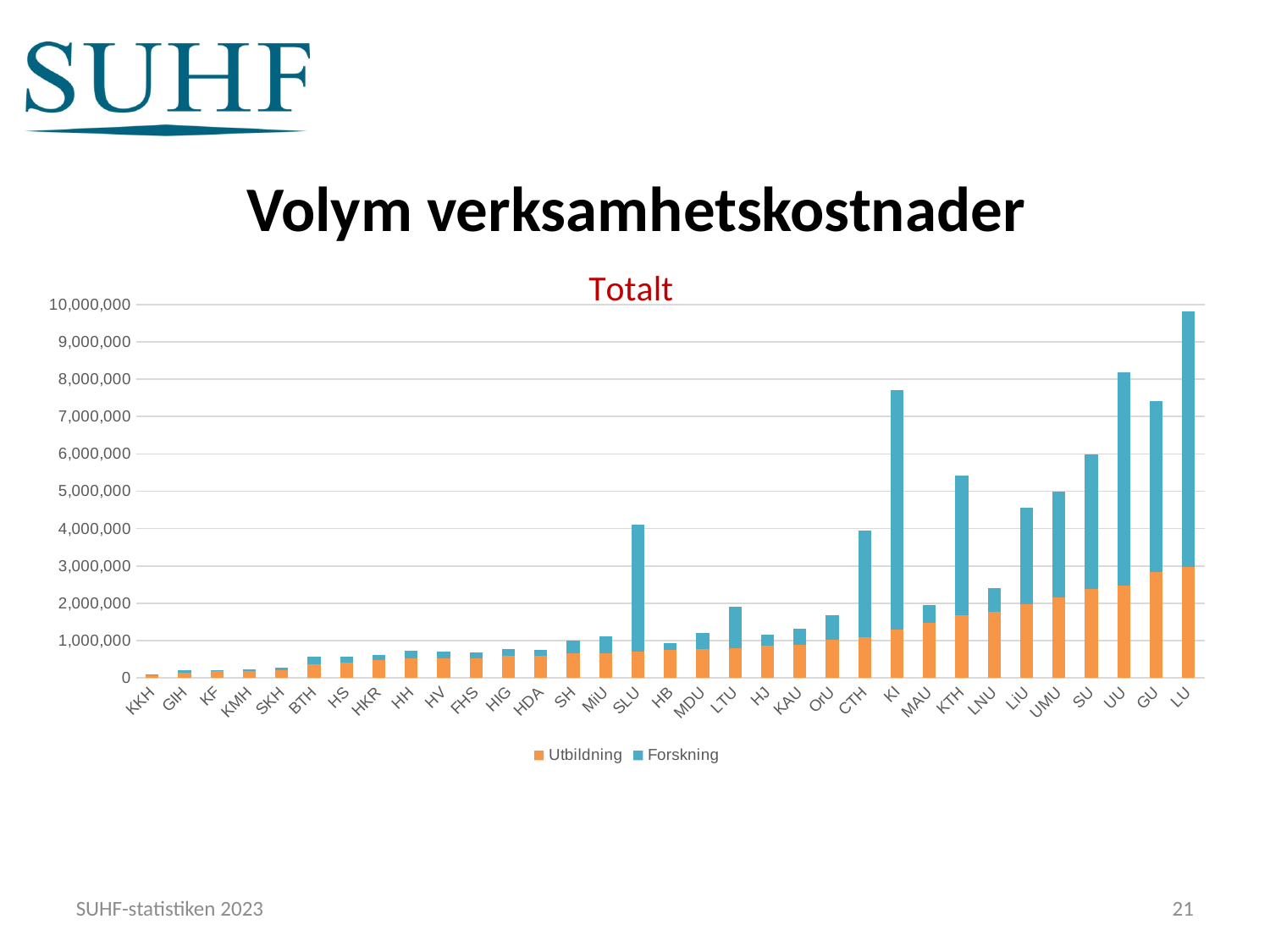
What kind of chart is shown on the slide? stacked bar chart How many categories are shown along the x axis? 33 Which two series are listed in the legend? Utbildning and Forskning Is the total value for KI greater or less than 7,000,000? greater Which has the larger total bar, KTH or CTH? KTH Is the total value for LU greater or less than 9,000,000? greater Which has the larger total bar, UU or GU? UU Which category has the lowest total bar? KKH Is the total value for SLU greater or less than 5,000,000? less Which category has the highest total bar? LU What is the title shown in red above the chart? Totalt How many series does the legend list? 2